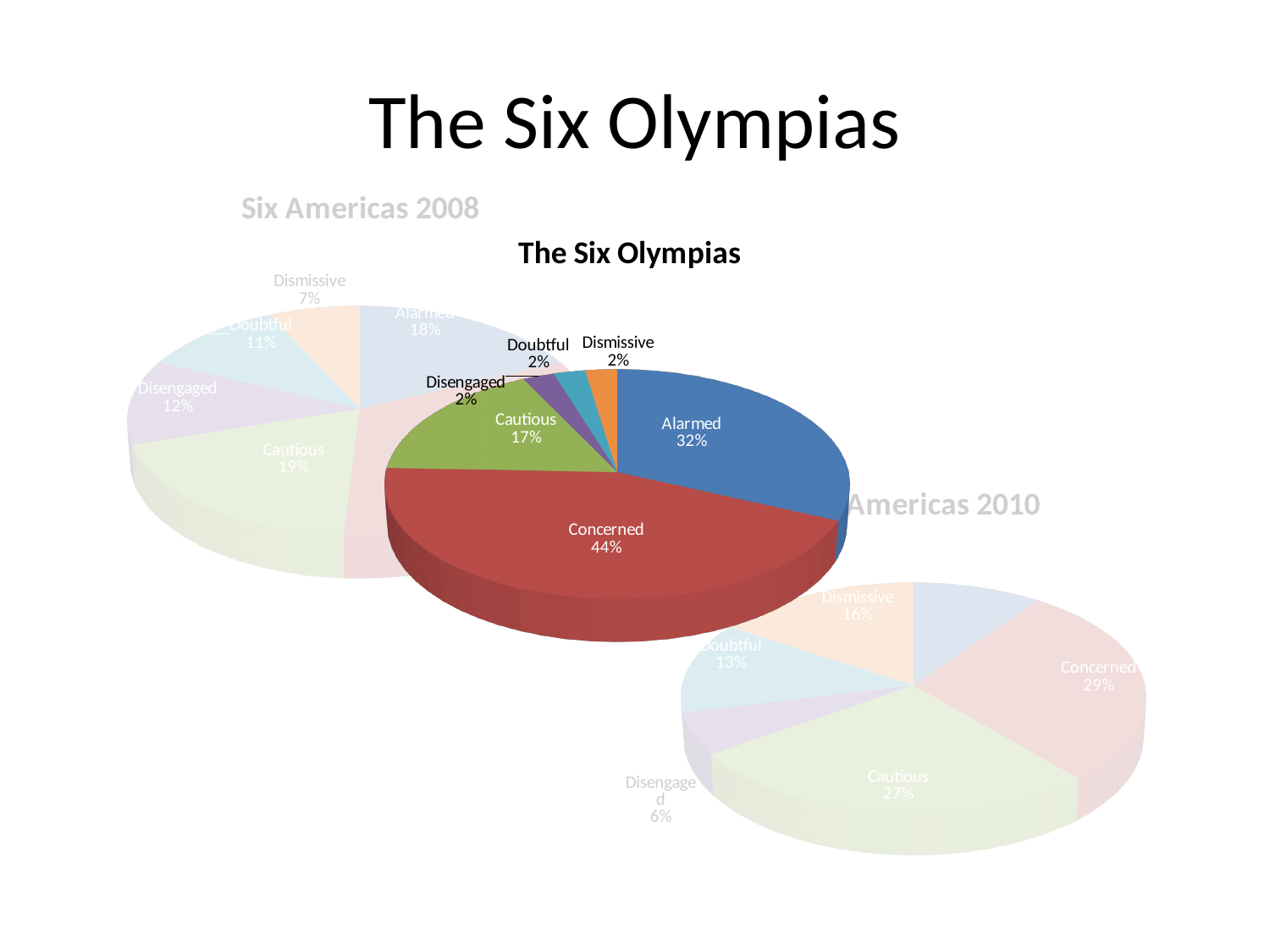
In The Six Olympias chart, what share is labelled for Alarmed? 32% In the Six Americas 2008 chart, what share is labelled for Cautious? 19% In The Six Olympias chart, what colour is the Concerned segment? Red What kind of chart is The Six Olympias? Pie chart In The Six Olympias chart, how many segments does the pie have? 6 In The Six Olympias chart, what share is labelled for Concerned? 44% In The Six Olympias chart, which segment is the largest? Concerned In The Six Olympias chart, what is the difference in percentage points between Concerned and Alarmed? 12 In the Six Americas 2010 chart, what share is labelled for Concerned? 29% In The Six Olympias chart, which is larger, Alarmed or Cautious? Alarmed In The Six Olympias chart, what share is labelled for Disengaged? 2% In The Six Olympias chart, what share is labelled for Cautious? 17%